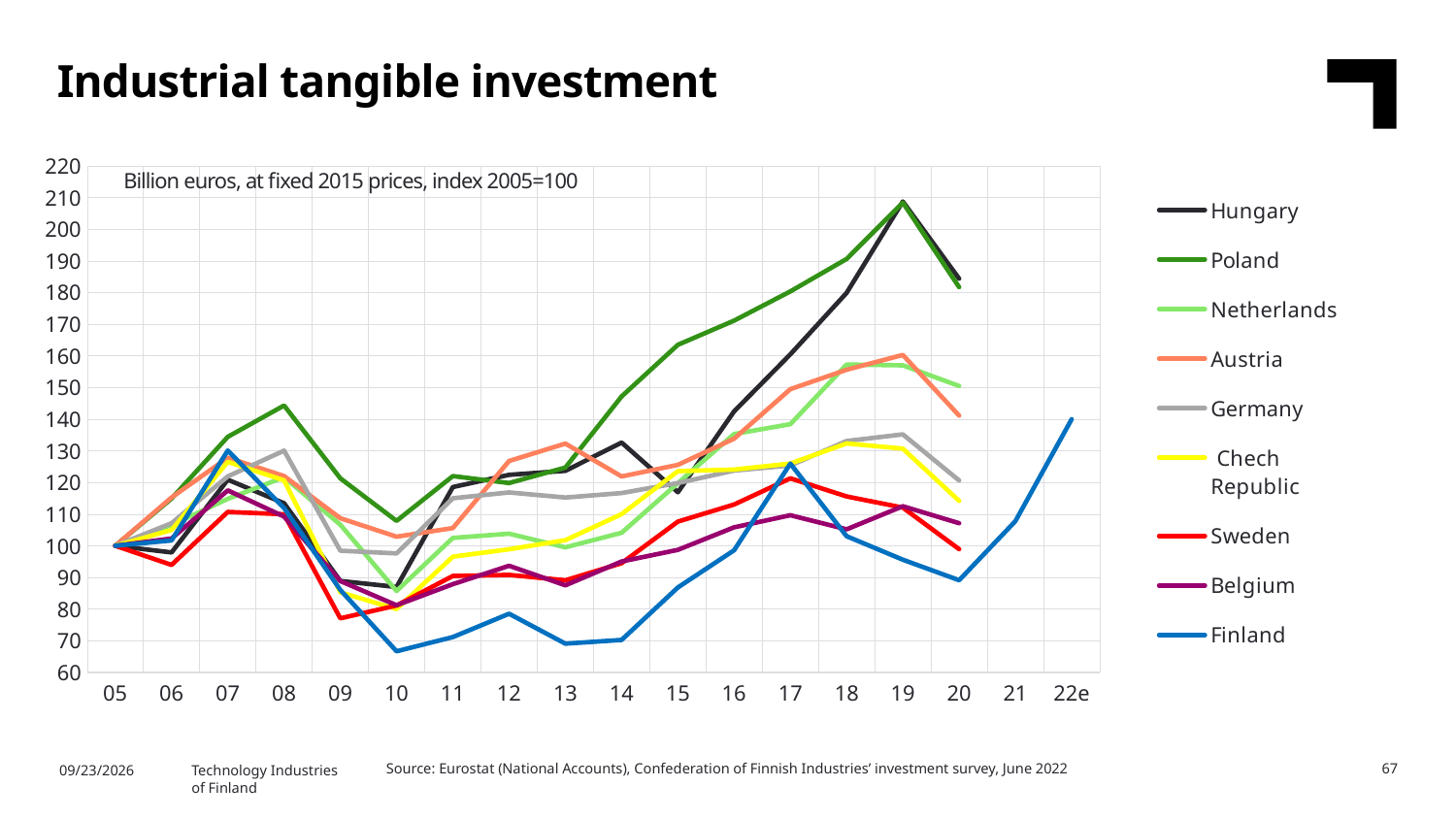
Which series has the highest value in 08? Poland How many year labels are shown on the x axis? 18 Which series has the lowest value in 20? Finland Which series has the lowest value in 10? Finland What type of chart is shown on the slide? line chart How many series does the legend list? 9 Does the Finland line rise or fall from 20 to 22e? rise Is the value for Finland in 10 greater or less than 80? less Is the value for Poland in 19 greater or less than 200? greater Which series is the only one plotted through 21 and 22e? Finland What is the value for Hungary in 05? 100 Which is larger in 20, Austria or Germany? Austria